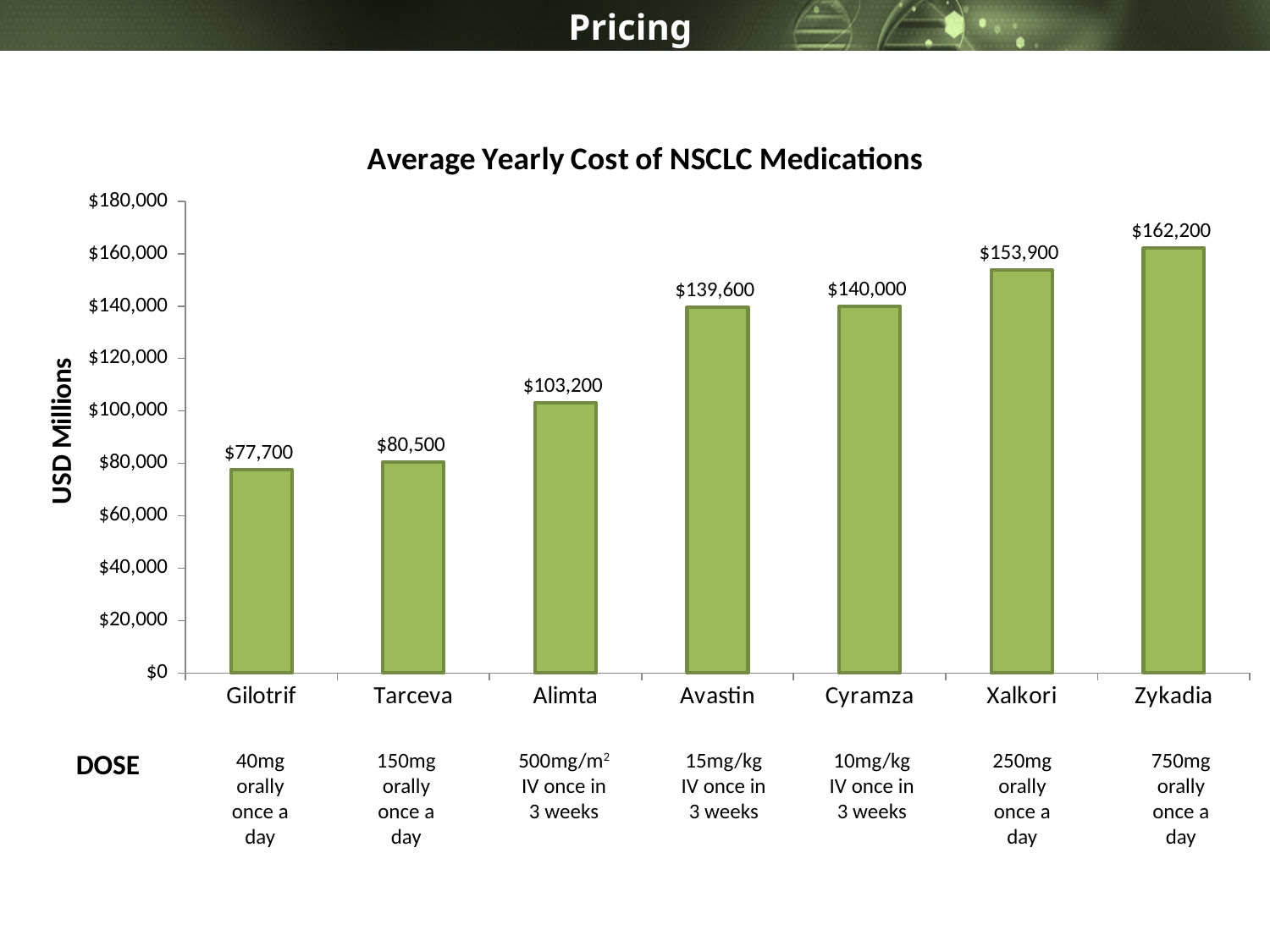
What is the difference in average yearly cost between Zykadia and Gilotrif? $84,500 What is the average yearly cost shown for Gilotrif? $77,700 What is the average yearly cost shown for Xalkori? $153,900 Which medication has the lowest average yearly cost? Gilotrif Which medication has the highest average yearly cost? Zykadia How many medications are shown in the chart? 7 What type of chart is used to show the average yearly cost of NSCLC medications? Bar chart Which has a higher average yearly cost, Alimta or Avastin? Avastin What is the title of the chart? Average Yearly Cost of NSCLC Medications What is the difference in average yearly cost between Tarceva and Gilotrif? $2,800 What is the average yearly cost shown for Alimta? $103,200 Is the value for Cyramza greater or less than $120,000? greater